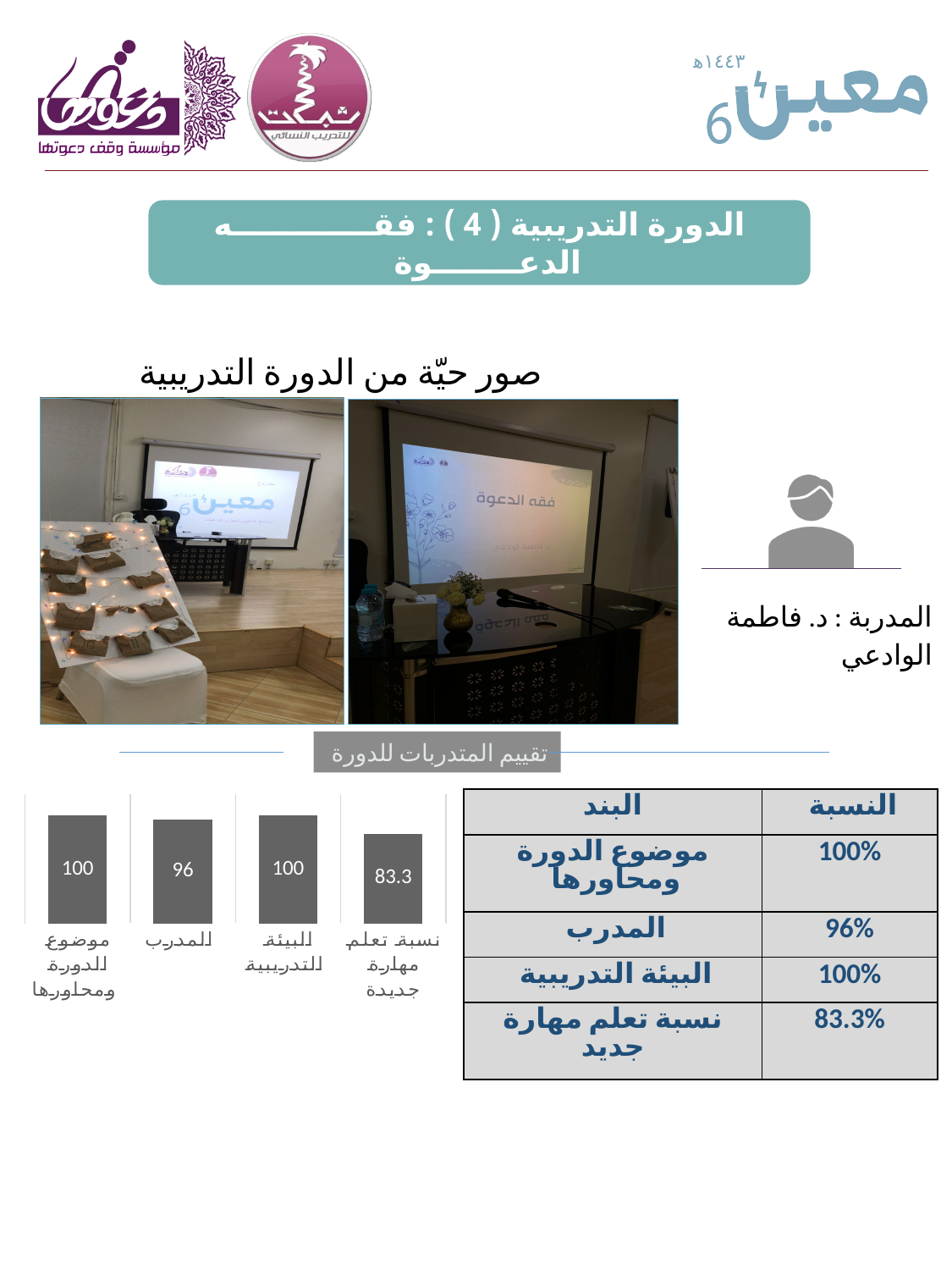
What is the value of the bar for موضوع الدورة ومحاورها? 100 What is the difference between the values for البيئة التدريبية and المدرب? 4 How many bars does the chart show? 4 What is the value of the bar for البيئة التدريبية? 100 What is the value of the bar for نسبة تعلم مهارة جديدة? 83.3 Which is larger, the value for المدرب or the value for نسبة تعلم مهارة جديدة? المدرب Which is larger, the value for البيئة التدريبية or the value for المدرب? البيئة التدريبية What is the difference between the values for المدرب and نسبة تعلم مهارة جديدة? 12.7 What colour are the bars in the chart? grey What is the value of the bar for المدرب? 96 What kind of chart is shown at the bottom left of the slide? bar chart Which category has the lowest bar in the chart? نسبة تعلم مهارة جديدة